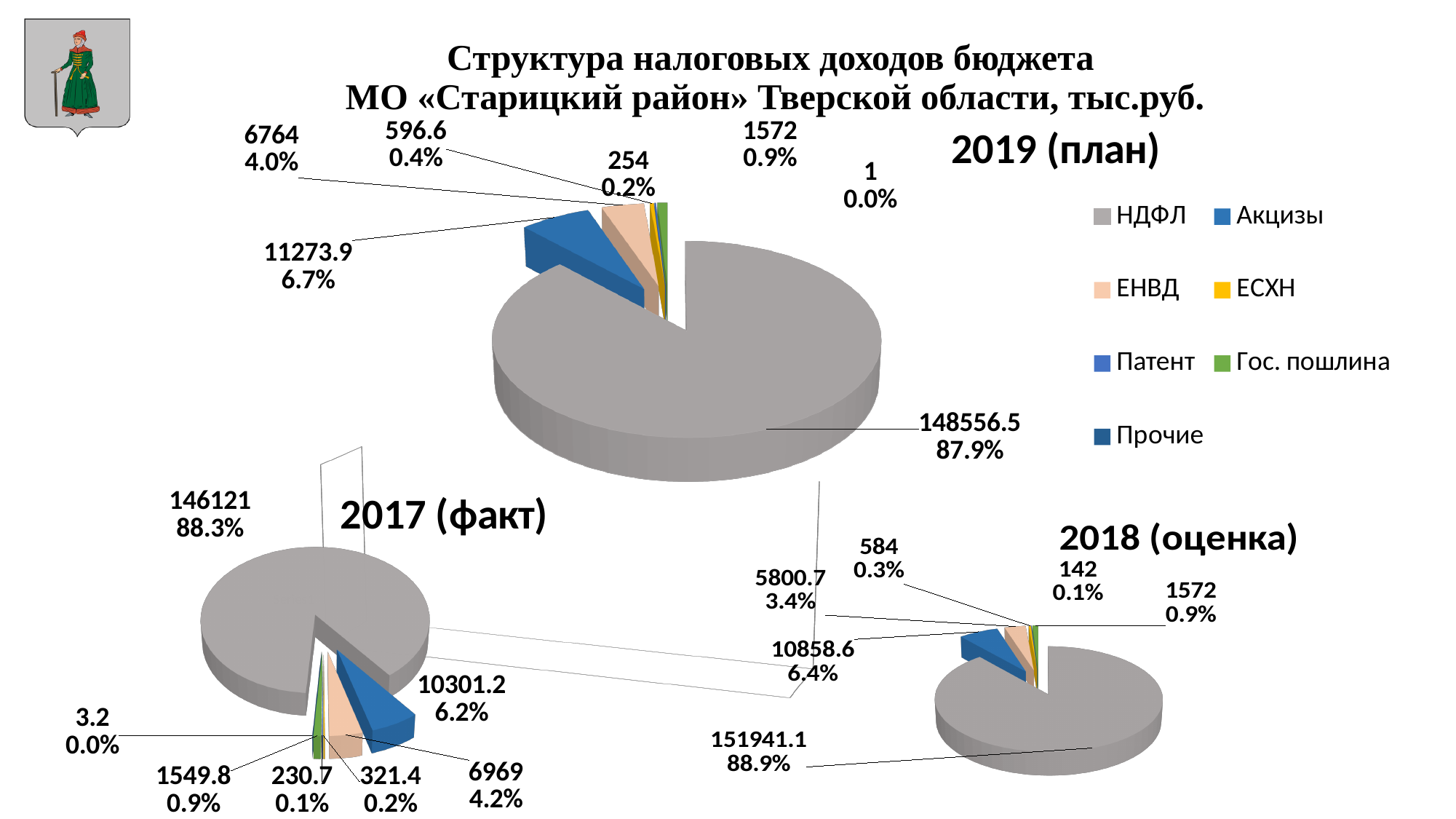
In the 2018 (оценка) chart, what share of the pie is НДФЛ? 88.9% In the 2019 (план) chart, what is the value for НДФЛ? 148556.5 In the 2019 (план) chart, what share of the pie is НДФЛ? 87.9% How many series does the legend list? 7 Which colour represents НДФЛ in the legend? Grey In the 2018 (оценка) chart, what is the value for Акцизы? 10858.6 In the 2019 (план) chart, which category has the largest slice? НДФЛ What kind of charts are shown on the slide? Pie charts In the 2017 (факт) chart, which is larger, Акцизы or ЕНВД? Акцизы How many pie charts are on the slide? 3 In the 2017 (факт) chart, what is the value for НДФЛ? 146121 In the 2019 (план) chart, what is the difference between the Акцизы value (11273.9) and the ЕНВД value (6764)? 4509.9